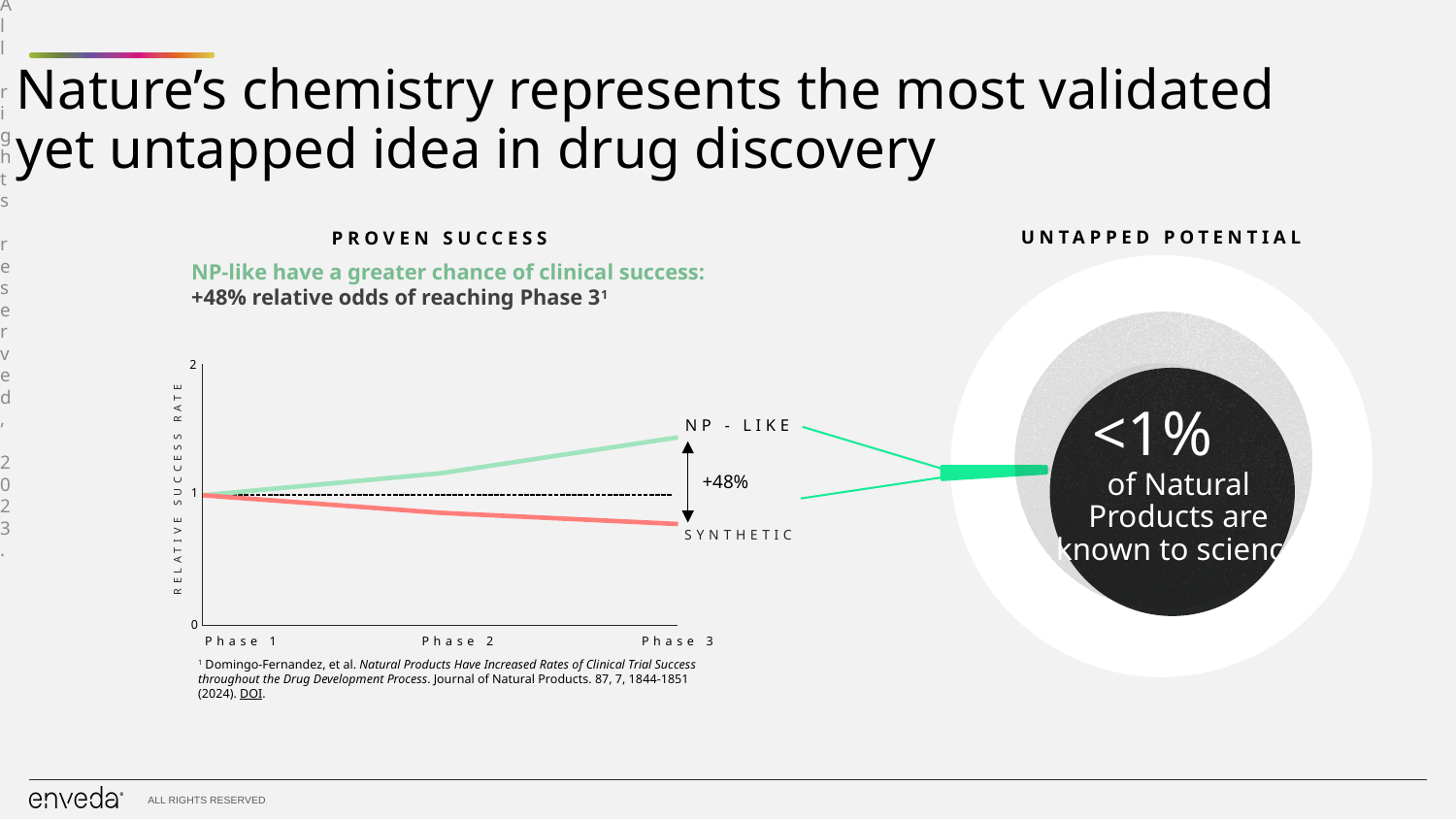
What is the title of the y axis of the line chart? Relative Success Rate At Phase 3, which series has the higher relative success rate, NP-LIKE or SYNTHETIC? NP-LIKE How many series are plotted in the line chart? 2 What kind of chart is shown under the 'Proven Success' heading? line chart Is the value for SYNTHETIC at Phase 3 greater or less than 1? less Is the value for NP-LIKE at Phase 3 greater or less than 1? greater What are the names of the two series plotted in the line chart? NP-LIKE and SYNTHETIC Does the SYNTHETIC line rise or fall from Phase 1 to Phase 3? fall Does the NP-LIKE line rise or fall from Phase 1 to Phase 3? rise What is the relative success rate of the NP-LIKE series at Phase 1? 1 How many phases are shown on the x axis of the line chart? 3 What is the relative success rate of the SYNTHETIC series at Phase 1? 1